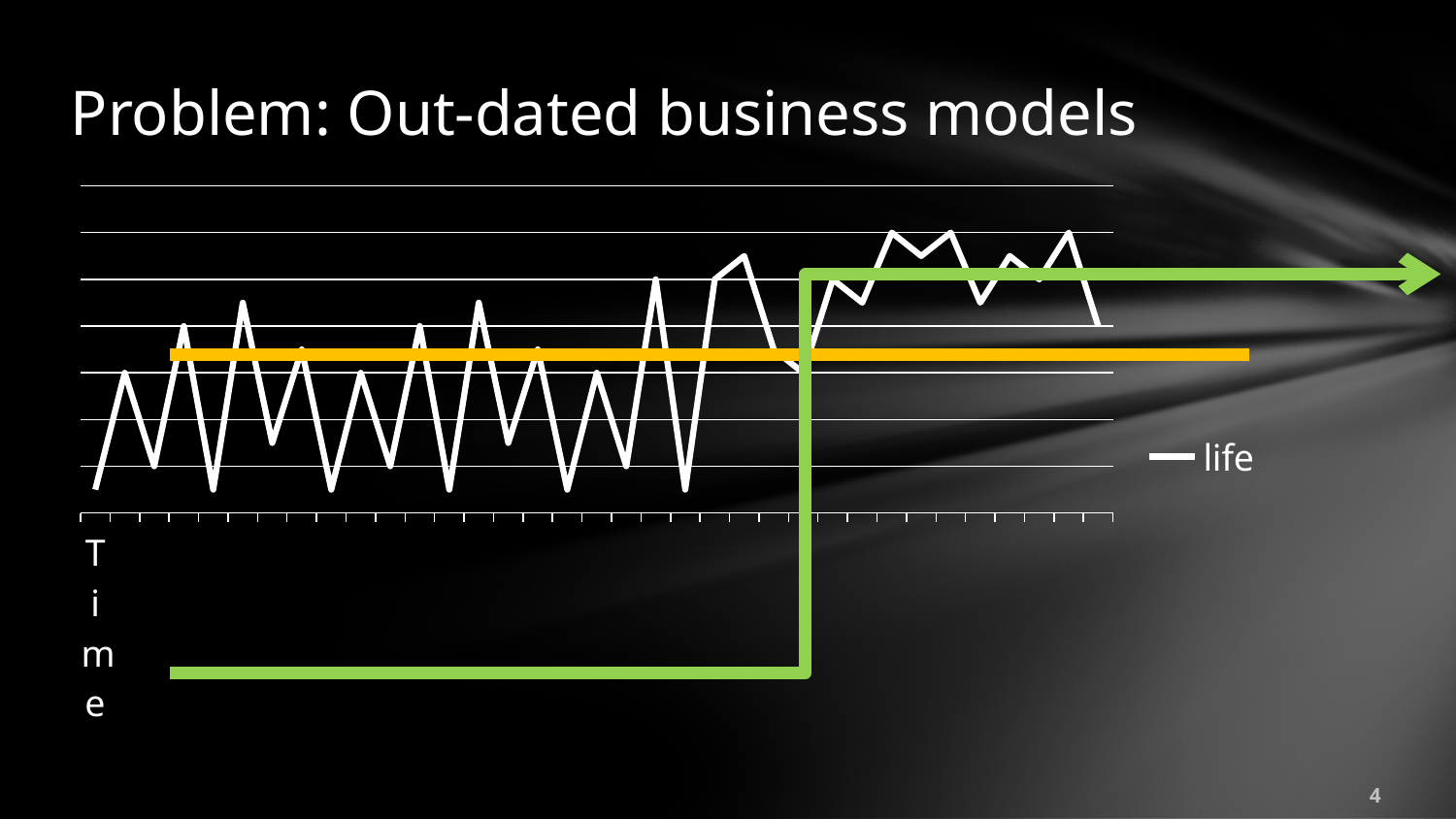
How many series does the chart's legend list? 1 What kind of chart is shown on the slide? line chart What label is shown along the horizontal axis of the chart? Time Does the 'life' line generally rise or fall from the left of the chart to the right? rise What is the name of the series shown in the chart's legend? life